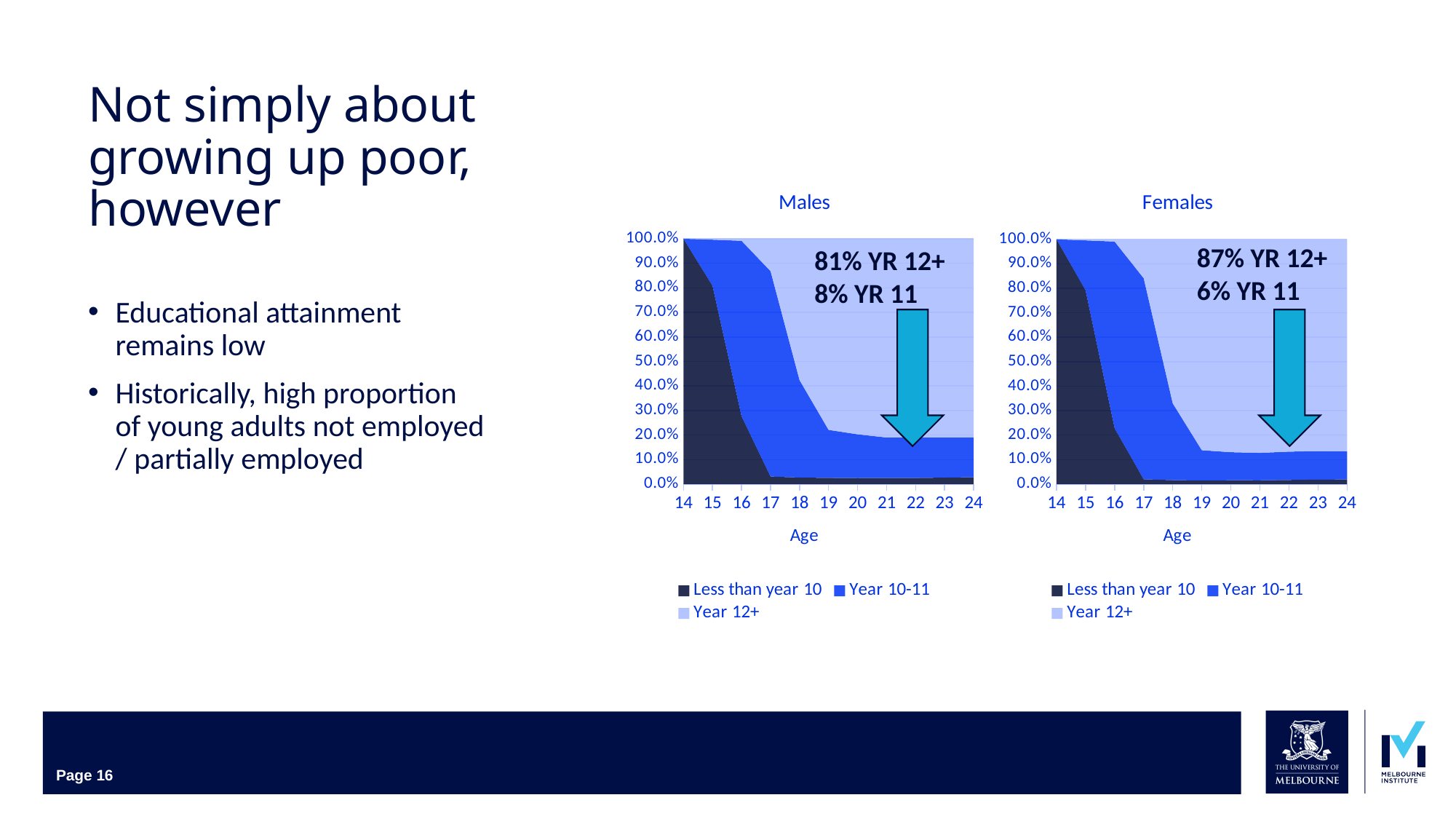
In the Males chart, is the share of 'Less than year 10' at age 14 greater or less than 90%? greater In the Females chart, what share is annotated for YR 12+? 87% Which chart shows the higher annotated YR 12+ share, Males or Females? Females How many series does the legend of the Females chart list? 3 What is the x-axis label on the Females chart? Age In the Males chart, does the 'Less than year 10' share rise or fall as age increases from 14 to 24? Fall In the Males chart, what share is annotated for YR 11? 8% How many age points are shown on the x axis of the Males chart? 11 In the Females chart, what share is annotated for YR 11? 6% In the Males chart, what share is annotated for YR 12+? 81% What type of chart is the Males chart? Stacked area chart What is the difference between the annotated YR 12+ shares in the Females and Males charts? 6%